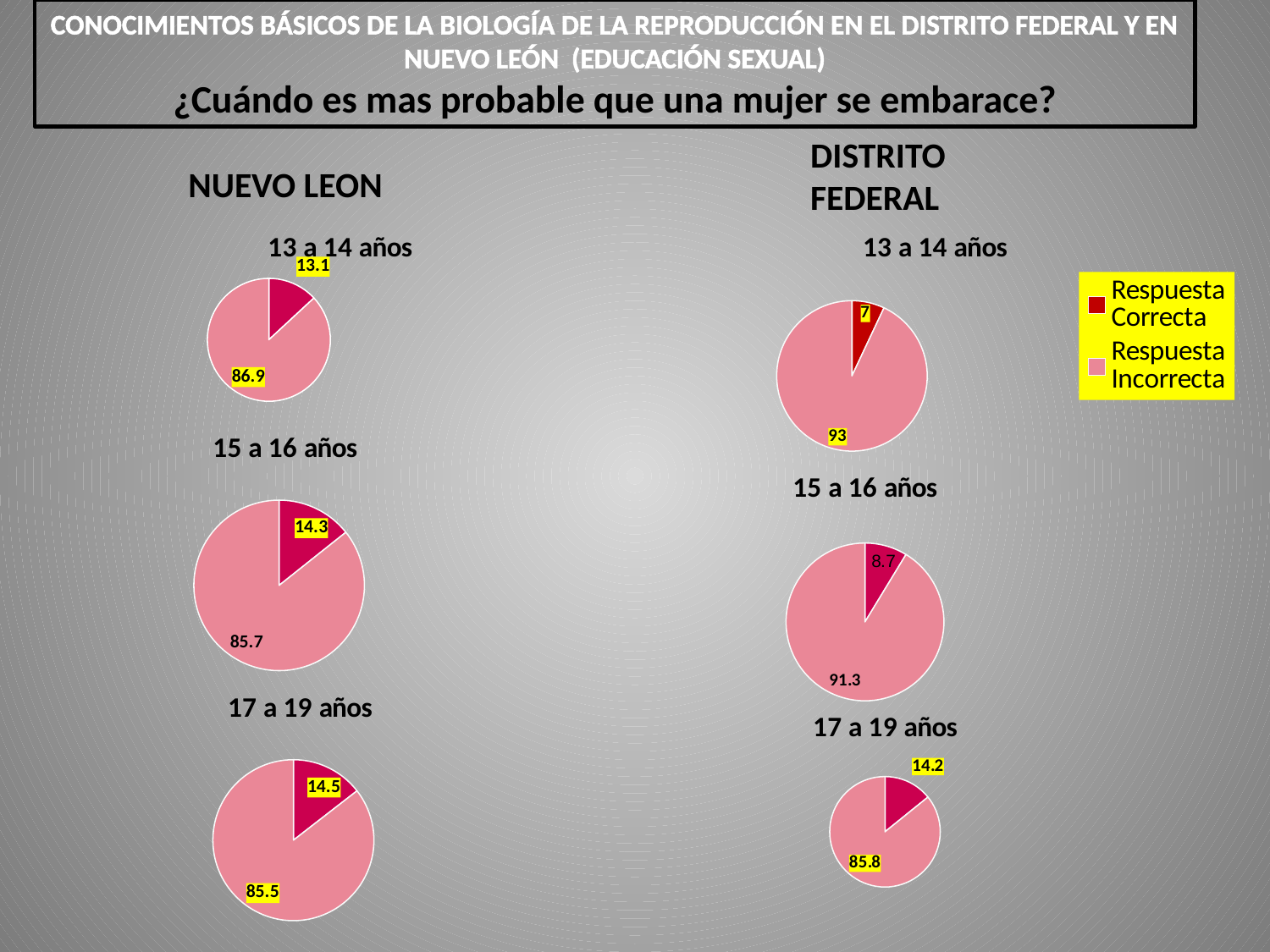
Which of the two '13 a 14 años' pie charts shows the larger Respuesta Correcta value, Nuevo León or Distrito Federal? Nuevo León In the Nuevo León '13 a 14 años' pie chart, what value is shown for Respuesta Correcta? 13.1 How many series does the legend list? 2 In the Distrito Federal '13 a 14 años' pie chart, what is the difference between the Respuesta Incorrecta and Respuesta Correcta values? 86 In the Distrito Federal '15 a 16 años' pie chart, what value is shown for Respuesta Incorrecta? 91.3 In the Distrito Federal '13 a 14 años' pie chart, what value is shown for Respuesta Correcta? 7 In the Distrito Federal '17 a 19 años' pie chart, what value is shown for Respuesta Incorrecta? 85.8 In the Nuevo León '17 a 19 años' pie chart, what value is shown for Respuesta Correcta? 14.5 In the Nuevo León '13 a 14 años' pie chart, what value is shown for Respuesta Incorrecta? 86.9 How many pie charts are shown on the slide in total? 6 In the Nuevo León '15 a 16 años' pie chart, which slice is larger, Respuesta Correcta or Respuesta Incorrecta? Respuesta Incorrecta What kind of chart is used to show the '15 a 16 años' data for Distrito Federal? Pie chart